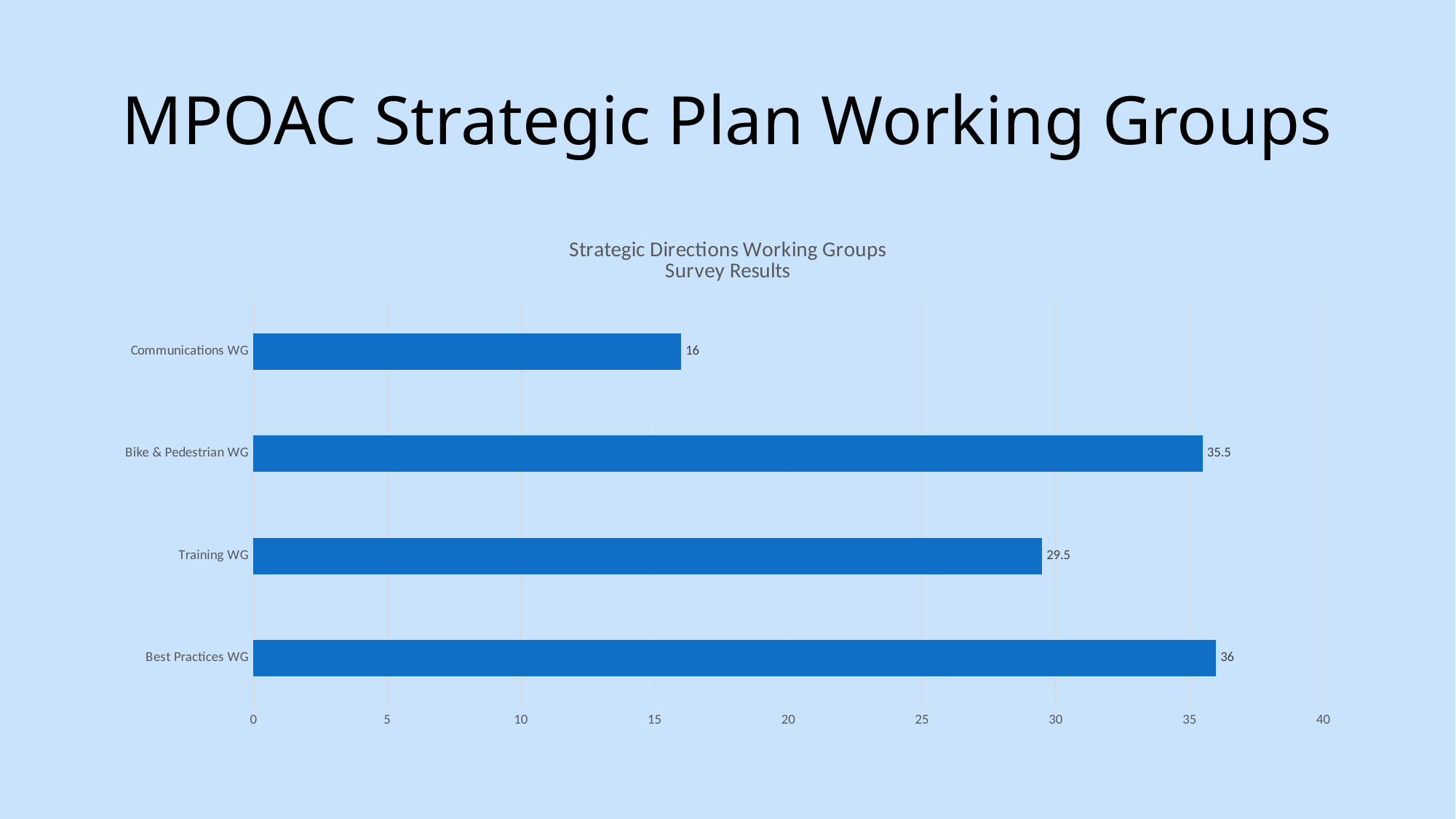
What is the value for Bike & Pedestrian WG? 35.5 What is the value for Communications WG? 16 Which working group has the highest value? Best Practices WG Which has a larger value, Training WG or Communications WG? Training WG What is the title of the chart? Strategic Directions Working Groups Survey Results What is the difference between the values for Bike & Pedestrian WG and Training WG? 6 What is the value for Training WG? 29.5 What is the difference between the values for Best Practices WG and Communications WG? 20 How many working groups are shown in the chart? 4 What is the value for Best Practices WG? 36 Which working group has the lowest value? Communications WG What kind of chart is shown on the slide? Bar chart